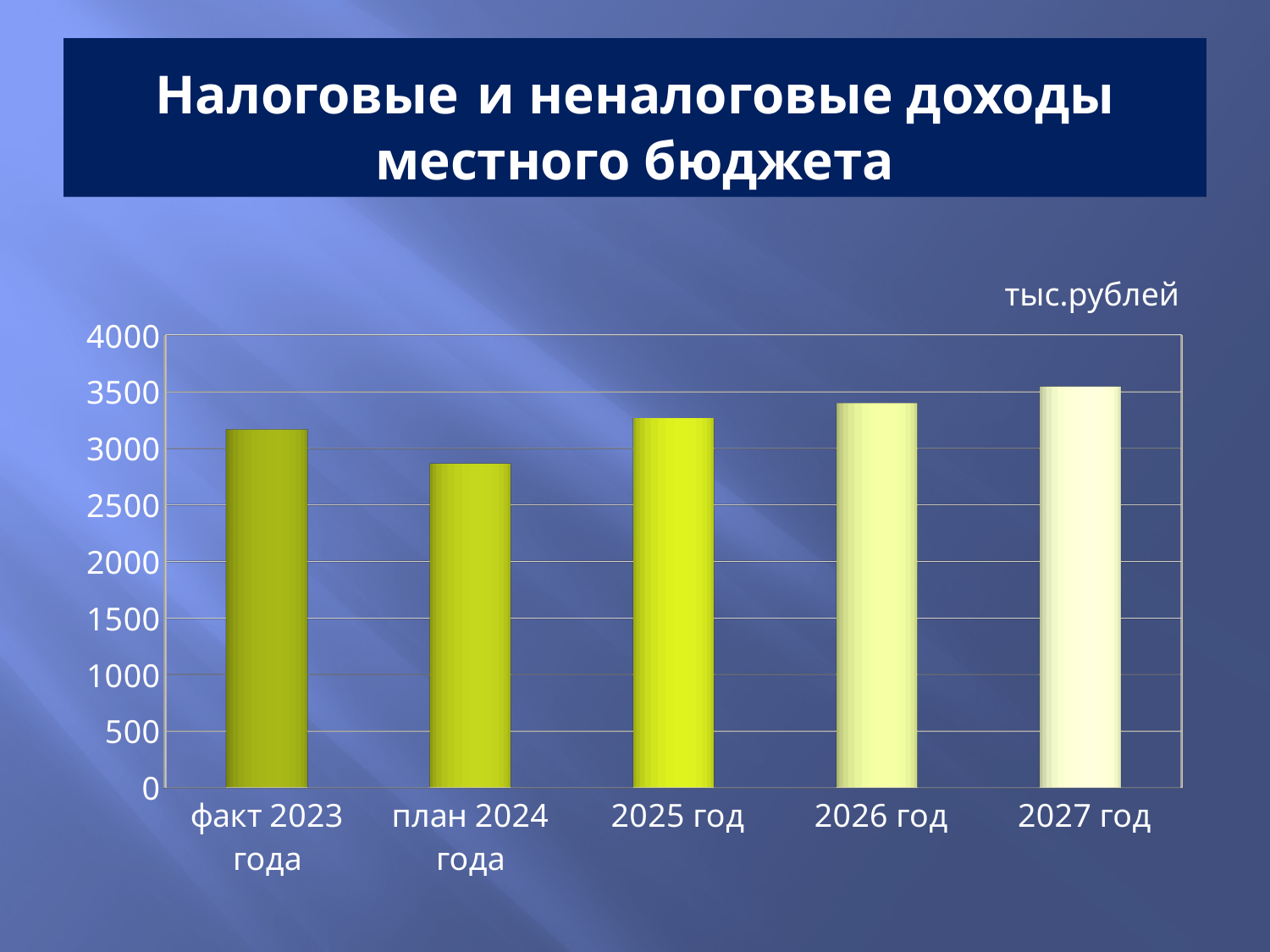
What kind of chart is shown on the slide? bar chart Which category has the highest value? 2027 год Is the value for 2026 год greater or less than 3500? less Is the value for факт 2023 года greater or less than 3000? greater Which is larger, the value for 2025 год or the value for 2026 год? 2026 год Which is larger, the value for факт 2023 года or the value for план 2024 года? факт 2023 года From план 2024 года to 2027 год, do the values rise or fall? rise Which category has the lowest value? план 2024 года How many bars (categories) does the chart show? 5 Is the value for план 2024 года greater or less than 3000? less In what units are the values on the chart given? тыс.рублей